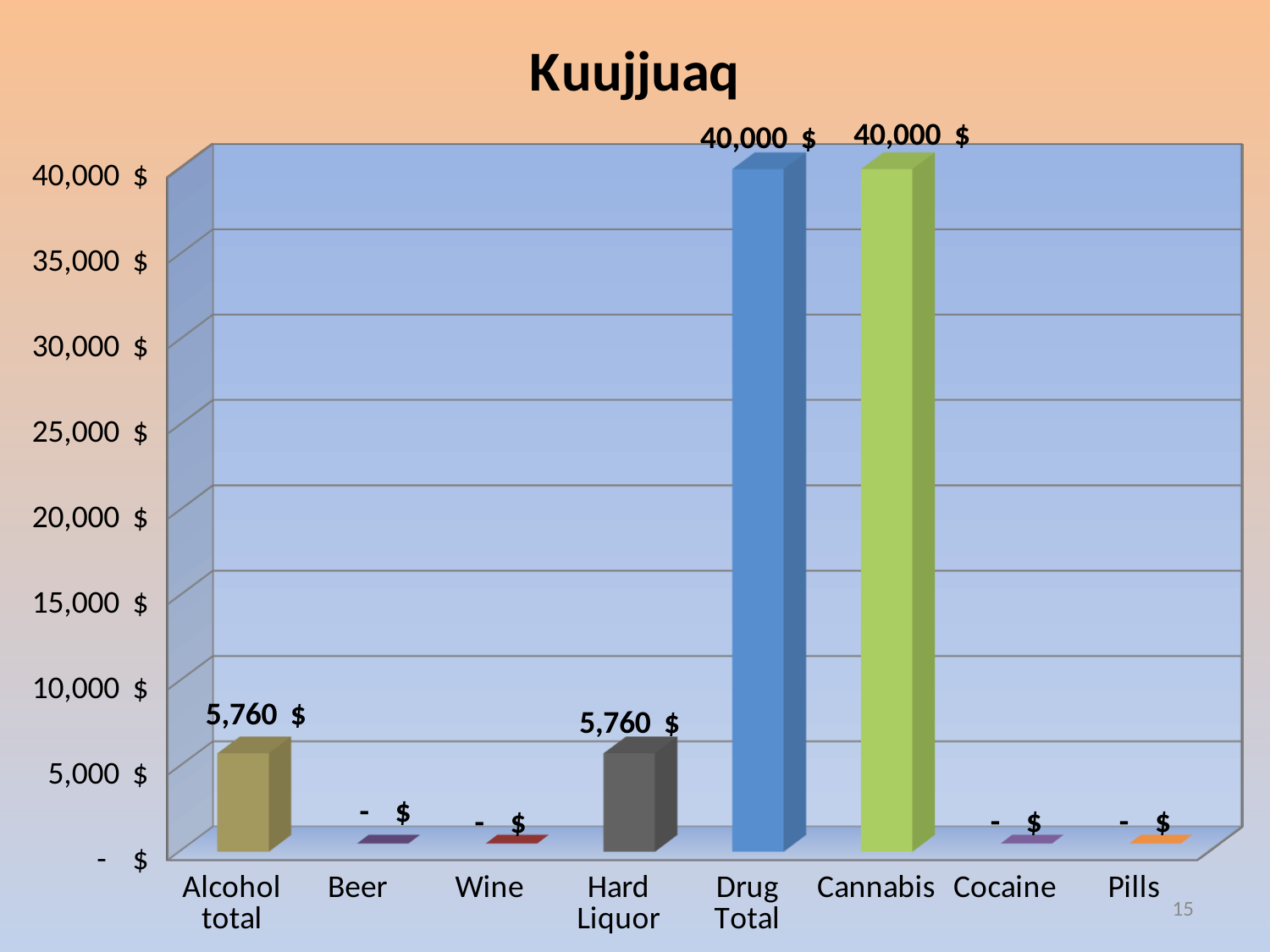
Which is larger, the value for Cannabis or the value for Hard Liquor? Cannabis What is the title of the chart? Kuujjuaq What is the value for Cannabis? 40,000 $ How many categories are shown on the x axis? 8 What is the value for Hard Liquor? 5,760 $ What kind of chart is shown on the slide? bar chart What value is shown for Beer? - $ What is the value for Drug Total? 40,000 $ What is the value for Alcohol total? 5,760 $ What is the highest value shown on the chart? 40,000 $ What is the difference between the Drug Total value and the Alcohol total value? 34,240 $ Is the value for Alcohol total greater or less than 10,000 $? less